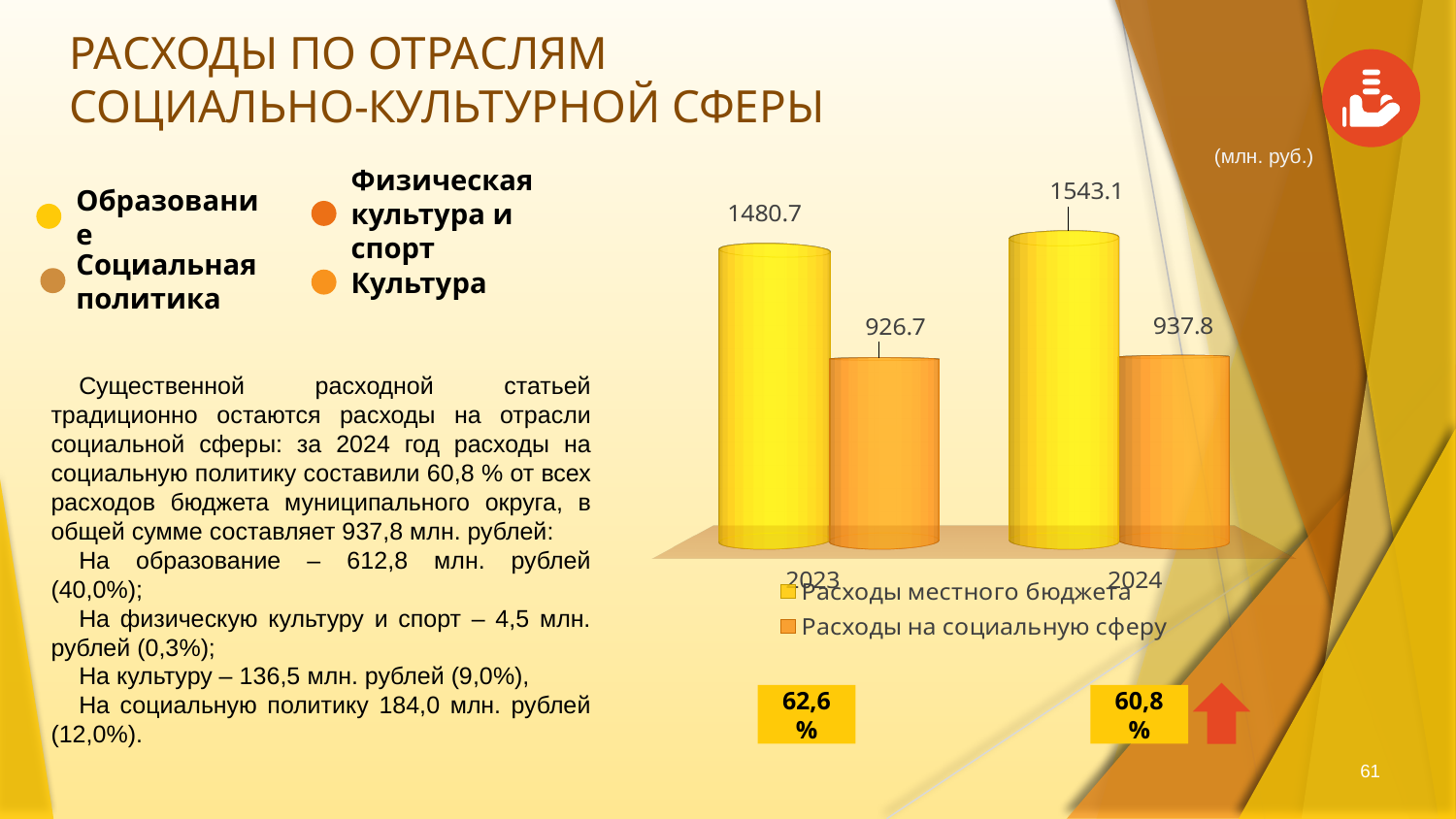
What kind of chart is shown on the slide? Bar chart Which is larger in 2023: Расходы местного бюджета or Расходы на социальную сферу? Расходы местного бюджета What is the value for Расходы на социальную сферу in 2023? 926.7 In which year is Расходы местного бюджета higher? 2024 What is the value for Расходы местного бюджета in 2024? 1543.1 What is the value for Расходы местного бюджета in 2023? 1480.7 How many series does the chart legend list? 2 What is the difference between Расходы местного бюджета in 2024 and in 2023? 62.4 In which year is Расходы на социальную сферу lower? 2023 What is the value for Расходы на социальную сферу in 2024? 937.8 How many years are shown on the x axis of the chart? 2 What is the difference between Расходы местного бюджета and Расходы на социальную сферу in 2024? 605.3